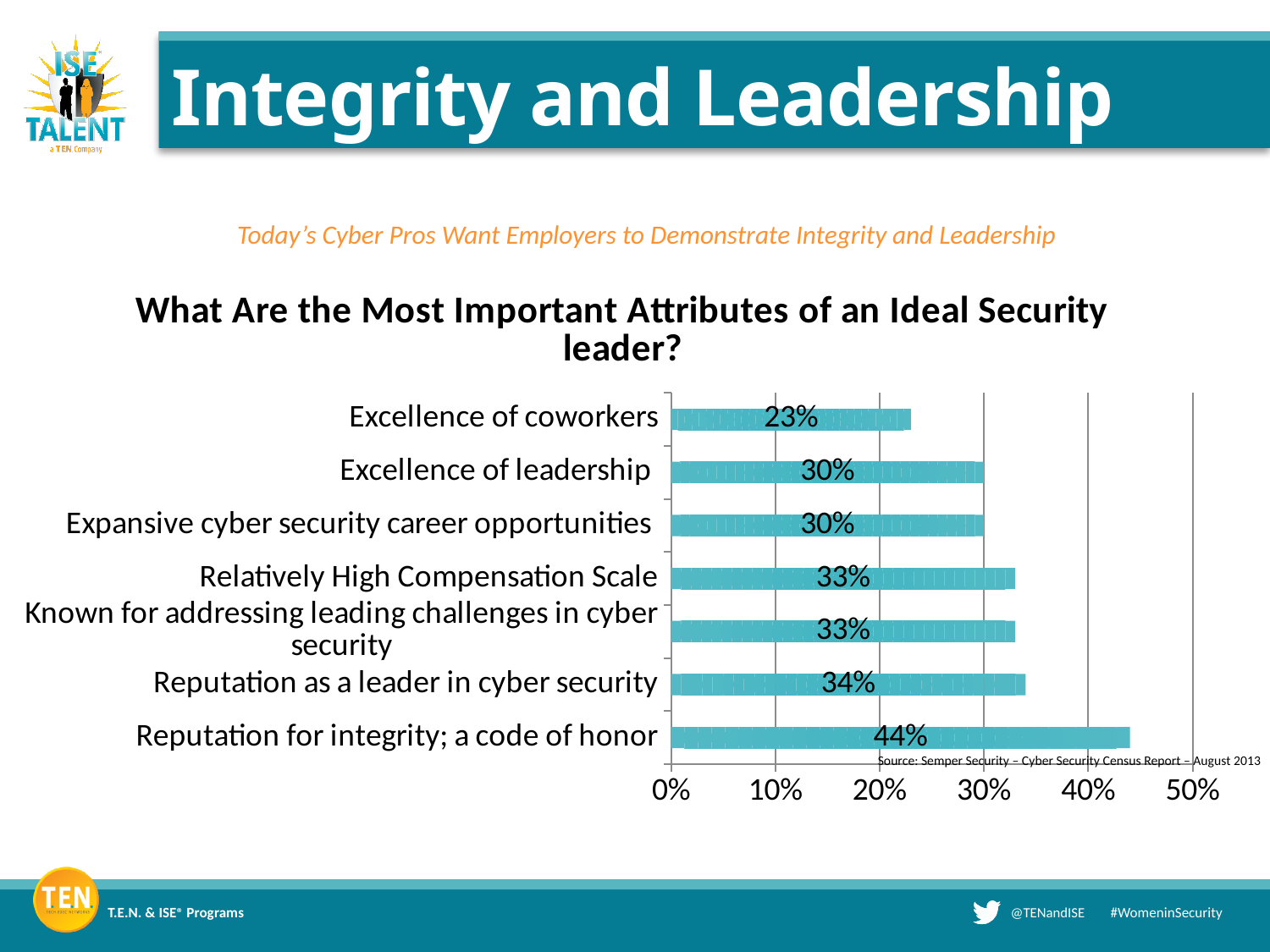
Which attribute has the lowest percentage? Excellence of coworkers What is the value for "Relatively High Compensation Scale"? 33% What is the value for "Excellence of coworkers"? 23% What percentage is shown for "Reputation for integrity; a code of honor"? 44% Which attribute has the highest percentage? Reputation for integrity; a code of honor What is the title of the chart? What Are the Most Important Attributes of an Ideal Security leader? What is the difference between the values for "Reputation for integrity; a code of honor" and "Excellence of coworkers"? 21% What kind of chart is shown on the slide? Bar chart How many attributes (categories) are plotted in the chart? 7 What value is shown for "Reputation as a leader in cyber security"? 34% Which is larger: the value for "Reputation as a leader in cyber security" or the value for "Excellence of leadership"? Reputation as a leader in cyber security Is the value for "Reputation for integrity; a code of honor" greater or less than 40%? greater